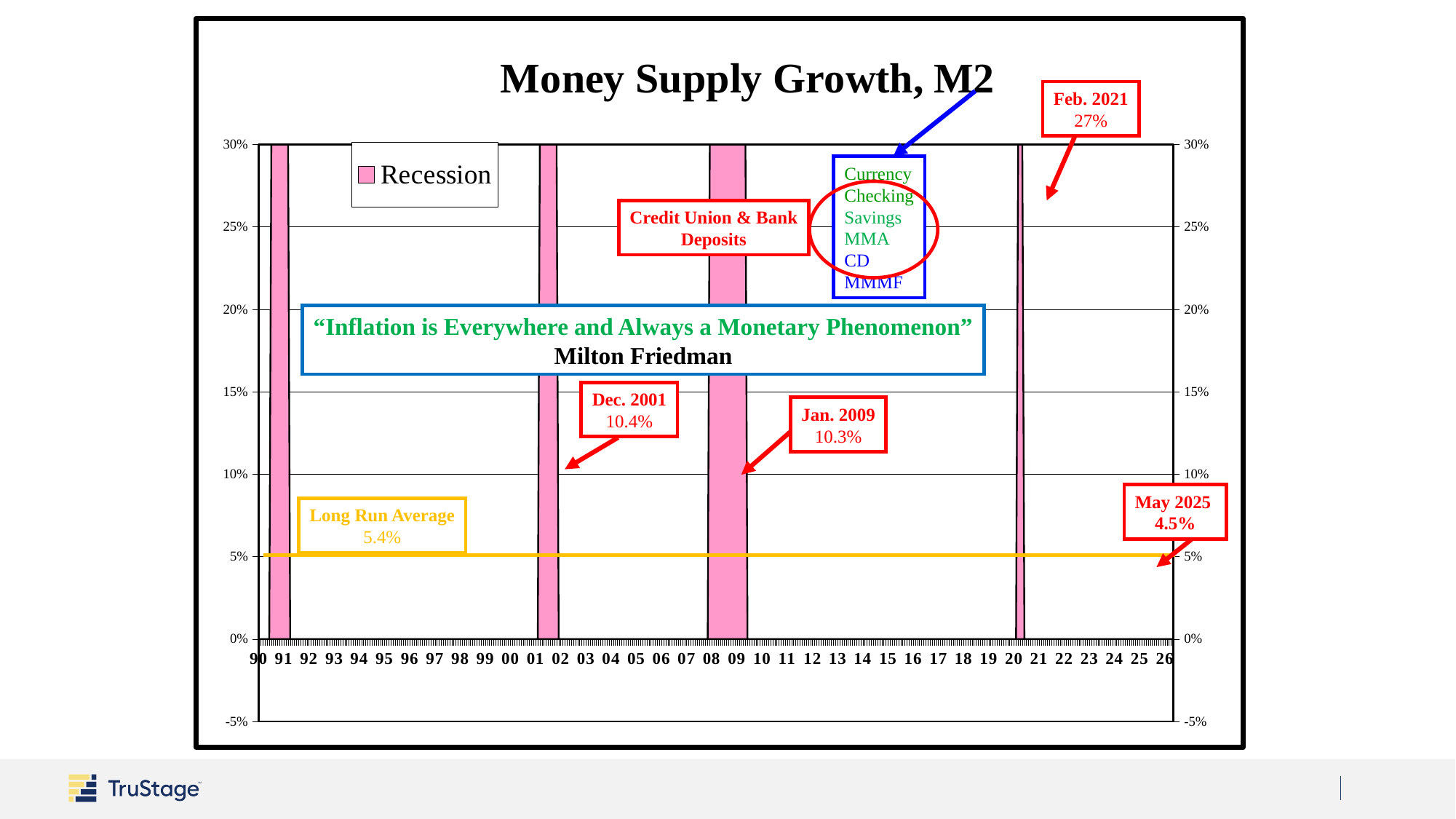
Is the annotated M2 growth value for May 2025 higher or lower than the long run average of 5.4%? lower How many recession periods (pink shaded bars) are shown on the chart? 4 What does the pink shading in the legend represent? Recession According to the annotation, what was M2 money supply growth in May 2025? 4.5% According to the annotation, what was M2 money supply growth in Feb. 2021? 27% According to the annotation, what was M2 money supply growth in Jan. 2009? 10.3% Which annotated date shows the highest M2 growth value: Dec. 2001, Jan. 2009, Feb. 2021 or May 2025? Feb. 2021 Which annotated date shows the lowest M2 growth value: Dec. 2001, Jan. 2009, Feb. 2021 or May 2025? May 2025 What is the long run average of M2 money supply growth shown on the chart? 5.4% What is the title of the chart? Money Supply Growth, M2 According to the annotation, what was M2 money supply growth in Dec. 2001? 10.4% What is the difference between the annotated M2 growth values for Feb. 2021 and May 2025? 22.5%